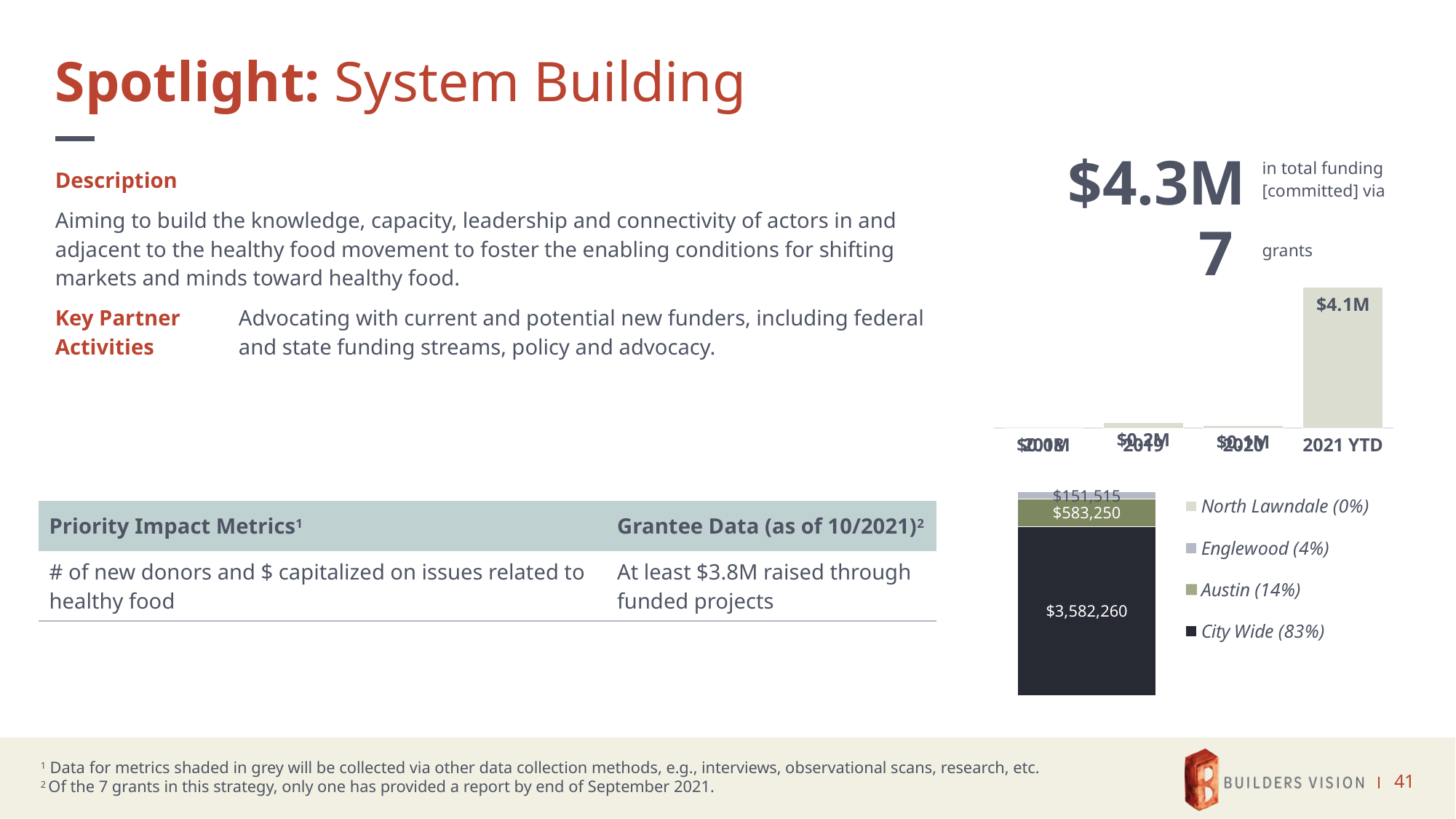
In the upper bar chart by year, what is the value for 2021 YTD? $4.1M How many series does the legend of the lower stacked bar chart list? 4 In the upper bar chart by year, which year has the highest value? 2021 YTD In the lower stacked bar chart, what share does City Wide represent according to the legend? 83% In the lower stacked bar chart, what is the value for City Wide? $3,582,260 In the lower stacked bar chart, what is the value for Austin? $583,250 How many year categories are shown in the upper bar chart? 4 What kind of chart is the upper chart on the right showing funding by year? bar chart In the upper bar chart by year, what is the value for 2019? $0.2M In the lower stacked bar chart, what is the difference between the City Wide value and the Austin value? $2,999,010 In the lower stacked bar chart, what is the value for Englewood? $151,515 In the lower stacked bar chart, which is larger, Austin or Englewood? Austin